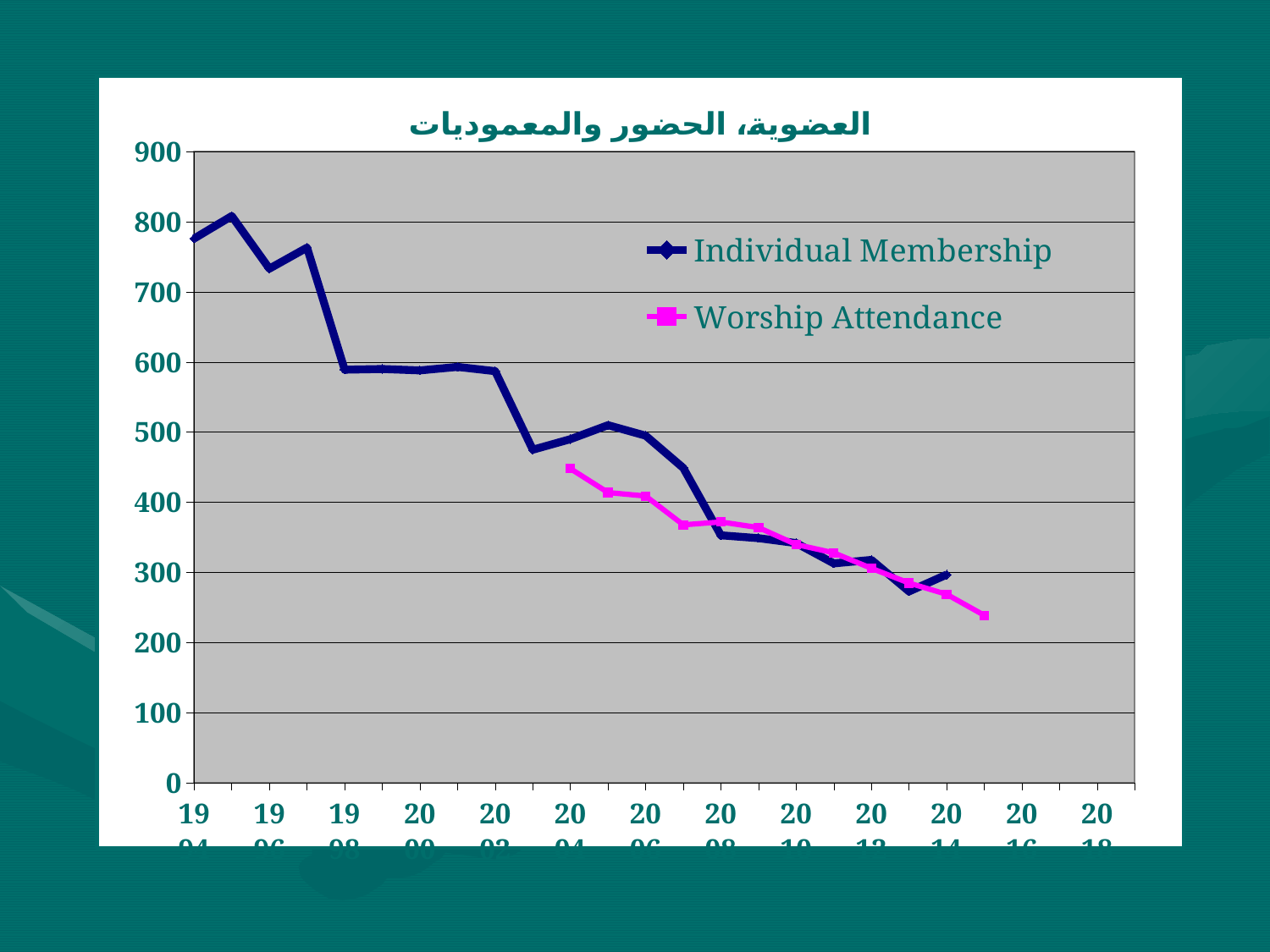
What are the two series named in the legend? Individual Membership and Worship Attendance How many series does the legend list? 2 Overall, do the Individual Membership values rise or fall from left to right along the x axis? fall Is the first (leftmost) Individual Membership value greater or less than 700? greater What kind of chart is shown on the slide? line chart Overall, do the Worship Attendance values rise or fall from left to right along the x axis? fall Which series is drawn in magenta (pink)? Worship Attendance Is the lowest Worship Attendance value greater or less than 200? greater Is the last (rightmost) Worship Attendance value greater or less than 300? less Which series starts further to the left on the chart, Individual Membership or Worship Attendance? Individual Membership